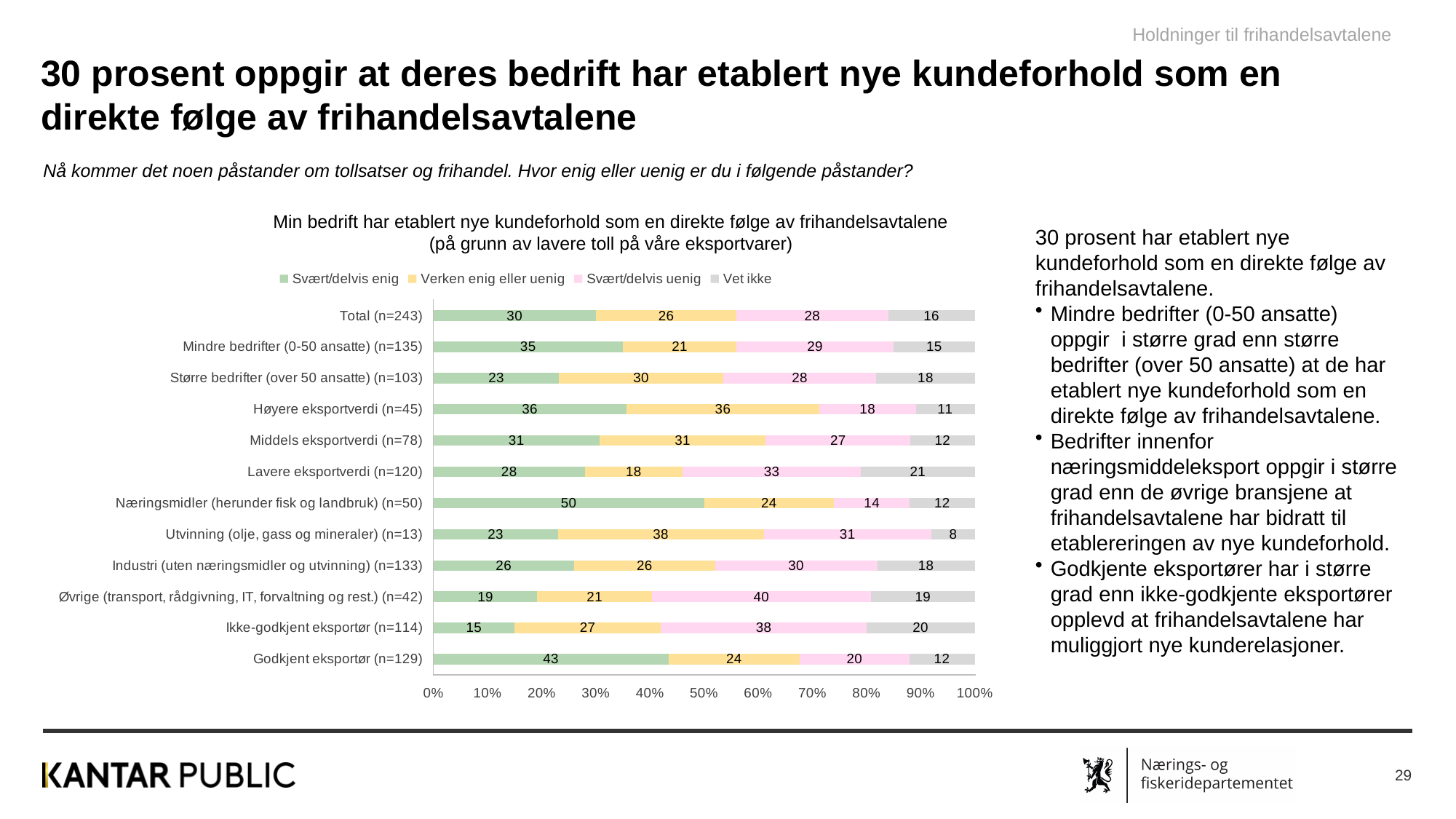
Which legend entry is shown in green? Svært/delvis enig What is the value of Svært/delvis uenig for Øvrige (transport, rådgivning, IT, forvaltning og rest.) (n=42)? 40 How many series does the legend list? 4 What is the total of the stacked bar for Total (n=243)? 100 What is the value of Vet ikke for Utvinning (olje, gass og mineraler) (n=13)? 8 Which category has the highest value for Svært/delvis enig? Næringsmidler (herunder fisk og landbruk) (n=50) Which has a higher Svært/delvis enig value: Mindre bedrifter (0-50 ansatte) (n=135) or Større bedrifter (over 50 ansatte) (n=103)? Mindre bedrifter (0-50 ansatte) (n=135) How many categories (bars) are shown in the chart? 12 What kind of chart is shown on the slide? Stacked bar chart Which category has the lowest value for Svært/delvis enig? Ikke-godkjent eksportør (n=114) What is the difference in Svært/delvis enig between Godkjent eksportør (n=129) and Ikke-godkjent eksportør (n=114)? 28 What is the value of Svært/delvis enig for Total (n=243)? 30